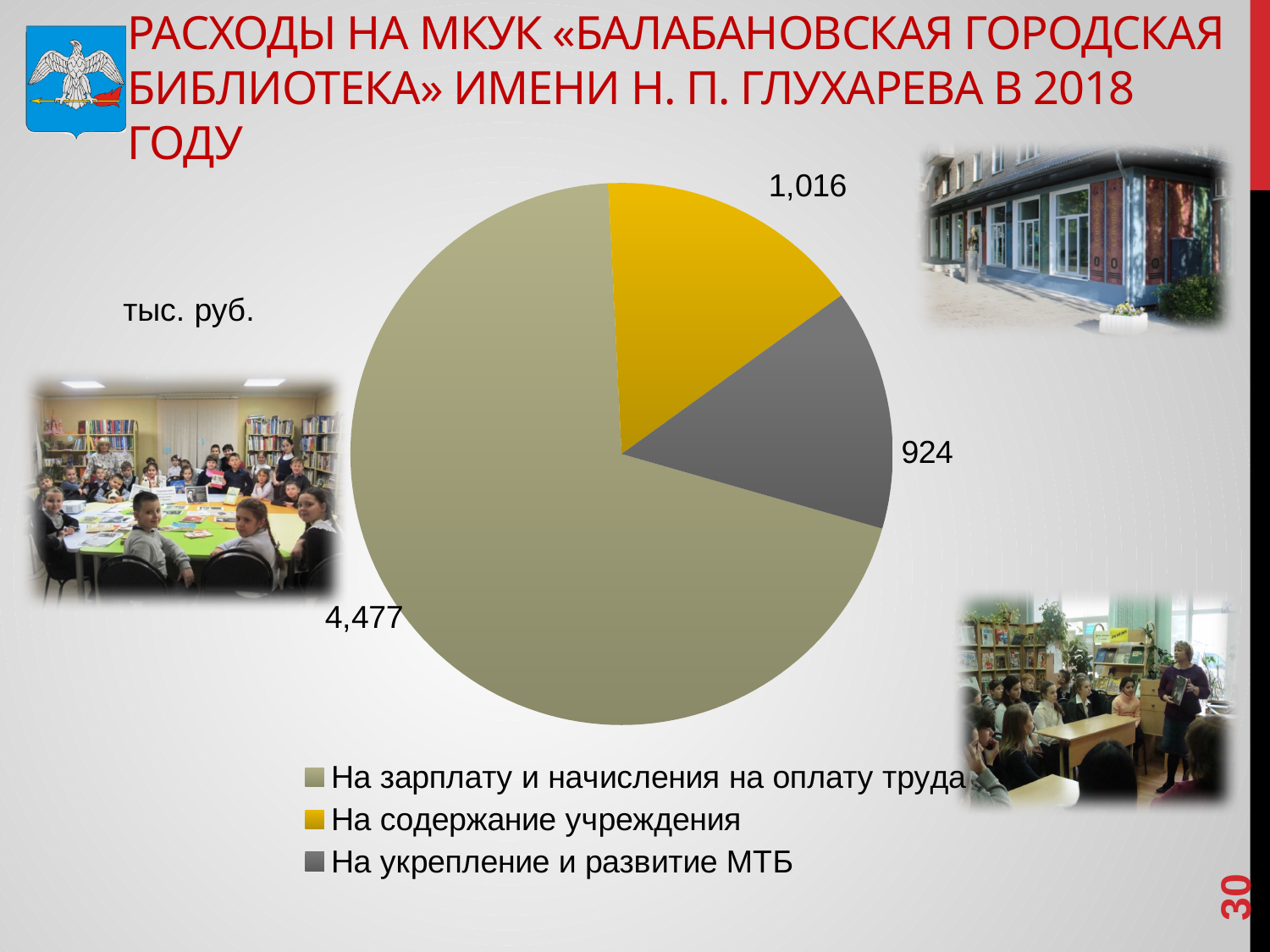
How many entries does the legend list? 3 Which category has the largest slice of the pie? На зарплату и начисления на оплату труда How many slices does the pie chart have? 3 Which category has the smallest slice of the pie? На укрепление и развитие МТБ What is the total of all three slices in the pie chart? 6,417 In what units are the values in the pie chart given? тыс. руб. What is the value for «На зарплату и начисления на оплату труда»? 4,477 What type of chart is shown on the slide? Pie chart What is the difference between the value for «На зарплату и начисления на оплату труда» and the value for «На содержание учреждения»? 3,461 Which is larger: the value for «На содержание учреждения» or the value for «На укрепление и развитие МТБ»? На содержание учреждения What is the value for «На содержание учреждения»? 1,016 What is the value for «На укрепление и развитие МТБ»? 924